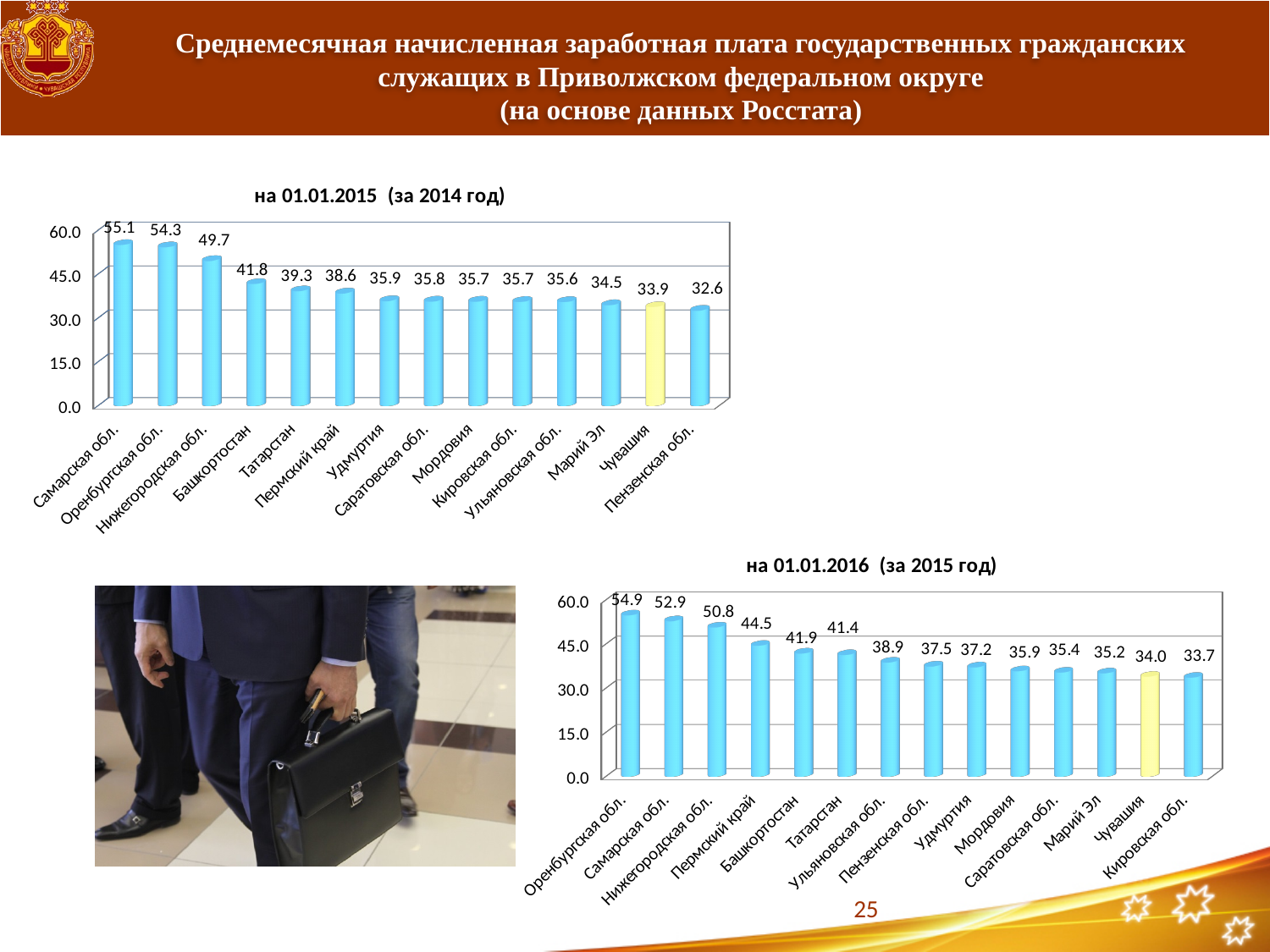
In the chart titled 'на 01.01.2016 (за 2015 год)', which is larger: the value for Башкортостан or the value for Ульяновская обл.? Башкортостан In the chart titled 'на 01.01.2015 (за 2014 год)', what is the difference between the values for Самарская обл. and Пензенская обл.? 22.5 In the chart titled 'на 01.01.2015 (за 2014 год)', do the values rise or fall from left to right along the x axis? Fall In the chart titled 'на 01.01.2015 (за 2014 год)', which category has the highest value? Самарская обл. In the chart titled 'на 01.01.2016 (за 2015 год)', which category has the highest value? Оренбургская обл. In the chart titled 'на 01.01.2015 (за 2014 год)', how many categories are shown? 14 What kind of chart is the chart titled 'на 01.01.2016 (за 2015 год)'? Bar chart In the chart titled 'на 01.01.2015 (за 2014 год)', what is the value for Чувашия? 33.9 In the chart titled 'на 01.01.2016 (за 2015 год)', what is the value for Пермский край? 44.5 In the chart titled 'на 01.01.2016 (за 2015 год)', what is the difference between the values for Оренбургская обл. and Чувашия? 20.9 In the chart titled 'на 01.01.2016 (за 2015 год)', which category has the lowest value? Кировская обл. In the chart titled 'на 01.01.2015 (за 2014 год)', which category has the lowest value? Пензенская обл.